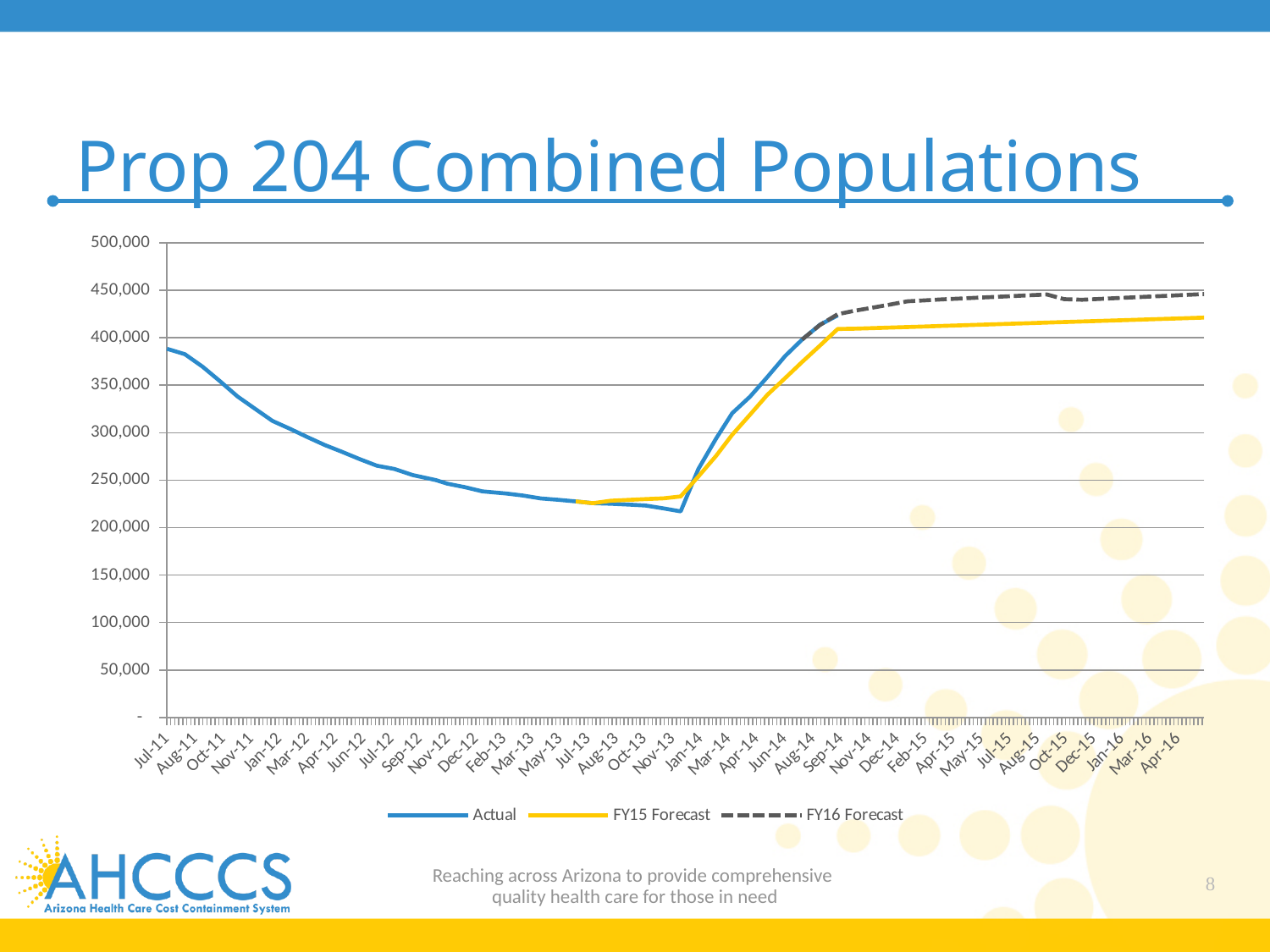
At Apr-16, which is higher: the FY15 Forecast or the FY16 Forecast? FY16 Forecast What kind of chart is shown on the slide? line chart At which month does the Actual series reach its highest value? Sep-14 Is the Actual value for Jul-11 greater or less than 350,000? greater How many series does the legend list? 3 What is the title of the chart? Prop 204 Combined Populations Does the Actual series rise or fall from Dec-13 to Aug-14? rise Is the FY15 Forecast value for Apr-16 greater or less than 450,000? less Which series is drawn with a dashed line? FY16 Forecast Is the Actual value for Nov-13 greater or less than 250,000? less Does the Actual series rise or fall from Jul-11 to Nov-13? fall